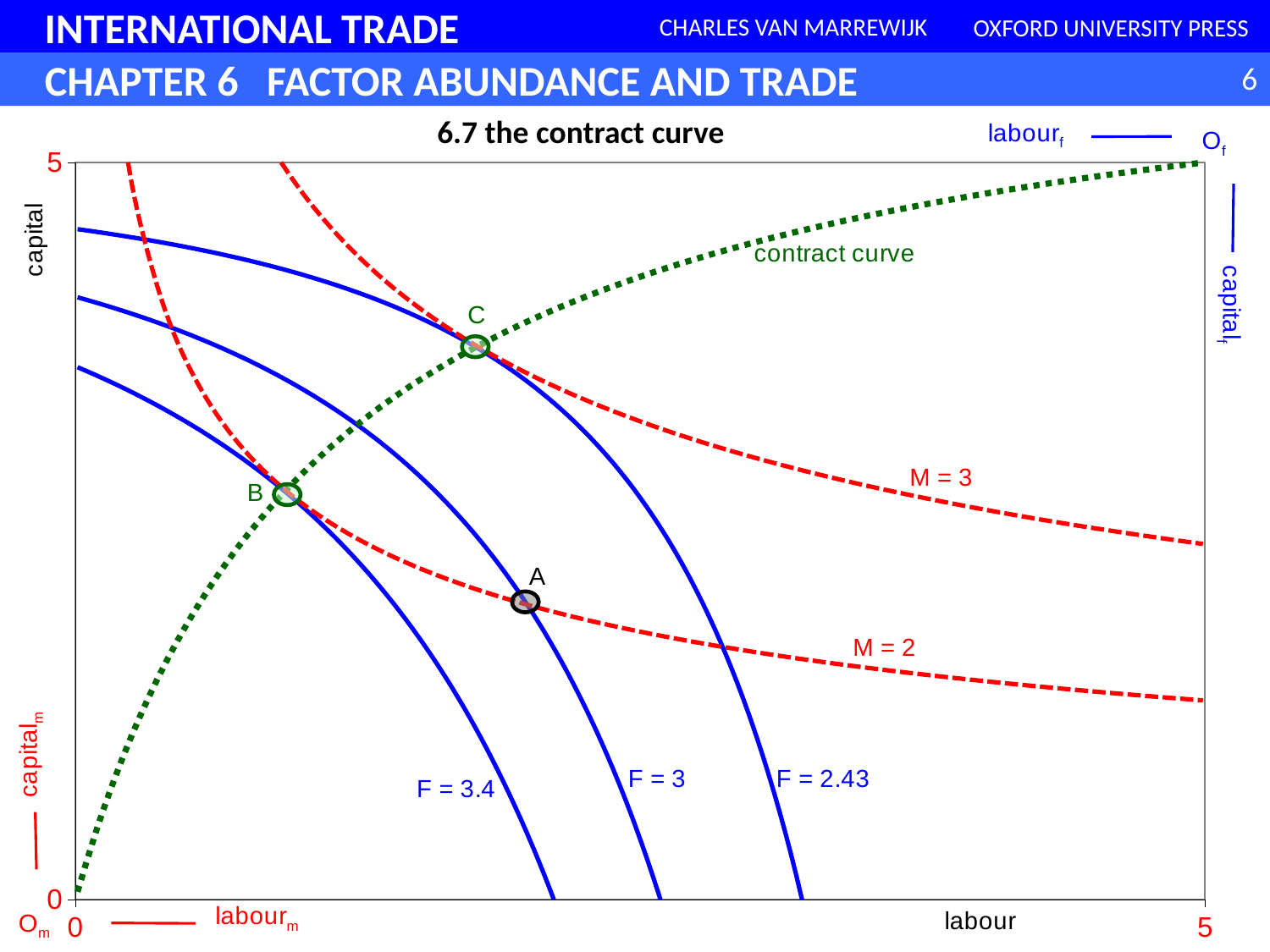
How many dashed red M isoquants are drawn in the chart? 2 What is the maximum value shown on the labour axis? 5 What colour and line style is used for the contract curve? green dotted Which labelled point lies at the intersection of M = 2 and F = 3.4? B Which labelled points lie on the contract curve? B and C Which labelled point lies at the intersection of M = 3 and F = 2.43? C What is the title of the chart? 6.7 the contract curve What kind of chart is shown on the slide? line chart Which M isoquant passes through point A? M = 2 What is the maximum value shown on the capital axis? 5 Which F isoquant passes through point A? F = 3 How many solid blue F isoquants are drawn in the chart? 3